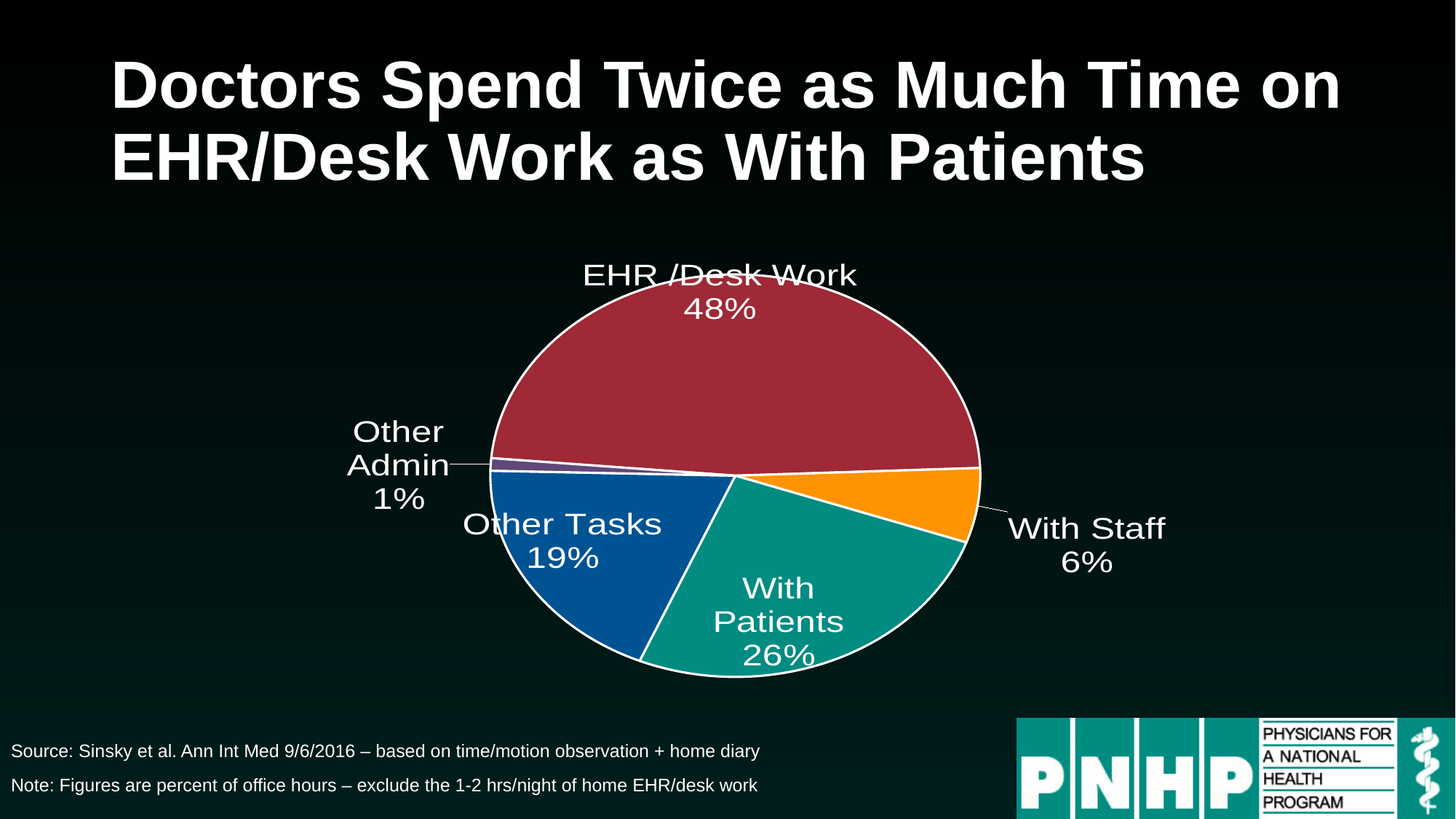
Which category takes the largest share of the pie? EHR /Desk Work How many percentage points larger is EHR/Desk Work than With Patients? 22 What share of office hours is spent on EHR/Desk Work? 48% Which category has the smallest slice? Other Admin What type of chart is shown on the slide? Pie chart How many slices does the pie chart have? 5 What is the value for Other Tasks? 19% What percentage is shown for With Staff? 6% What colour is the With Patients slice? Teal What is the value for Other Admin? 1% What percentage of office hours is spent With Patients? 26% Which is larger, Other Tasks or With Staff? Other Tasks